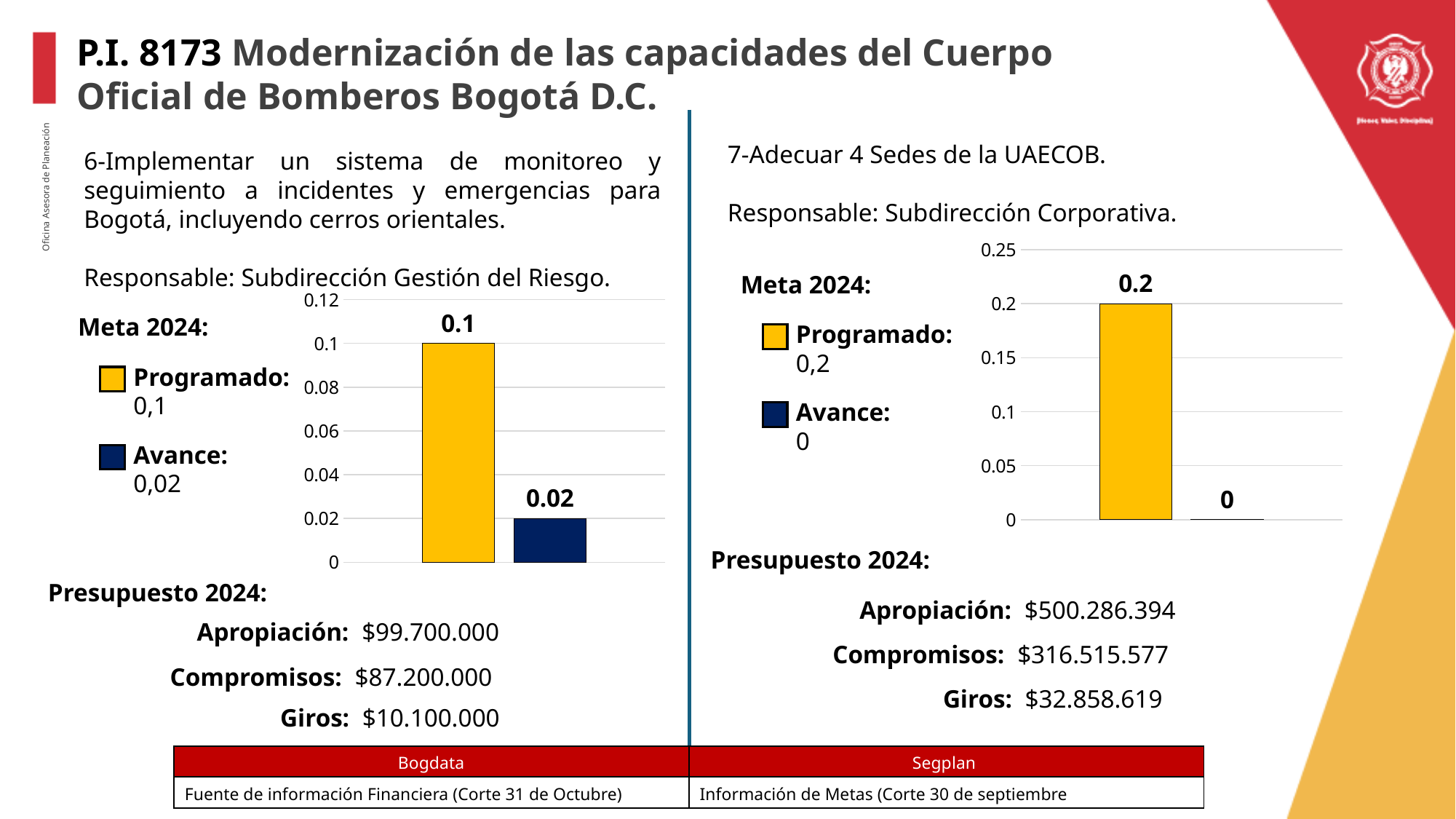
On the right chart (Meta 7), which bar is the lowest? Avance On the right chart (Meta 7), what is the value of the Programado bar? 0.2 On the left chart (Meta 6), which bar is taller, Programado or Avance? Programado On the right chart (Meta 7), what colour is the Programado bar? Yellow On the left chart (Meta 6), what is the value of the Programado bar? 0.1 How many bars are plotted on the right chart (Meta 7)? 2 On the left chart (Meta 6), what is the value of the Avance bar? 0.02 What type of chart is used on the left side of the slide for Meta 6? Bar chart On the left chart (Meta 6), what is the difference between the Programado and Avance values? 0.08 On the right chart (Meta 7), what is the difference between the Programado and Avance values? 0.2 On the left chart (Meta 6), is the Avance value greater or less than 0.04? less On the right chart (Meta 7), what is the value of the Avance bar? 0